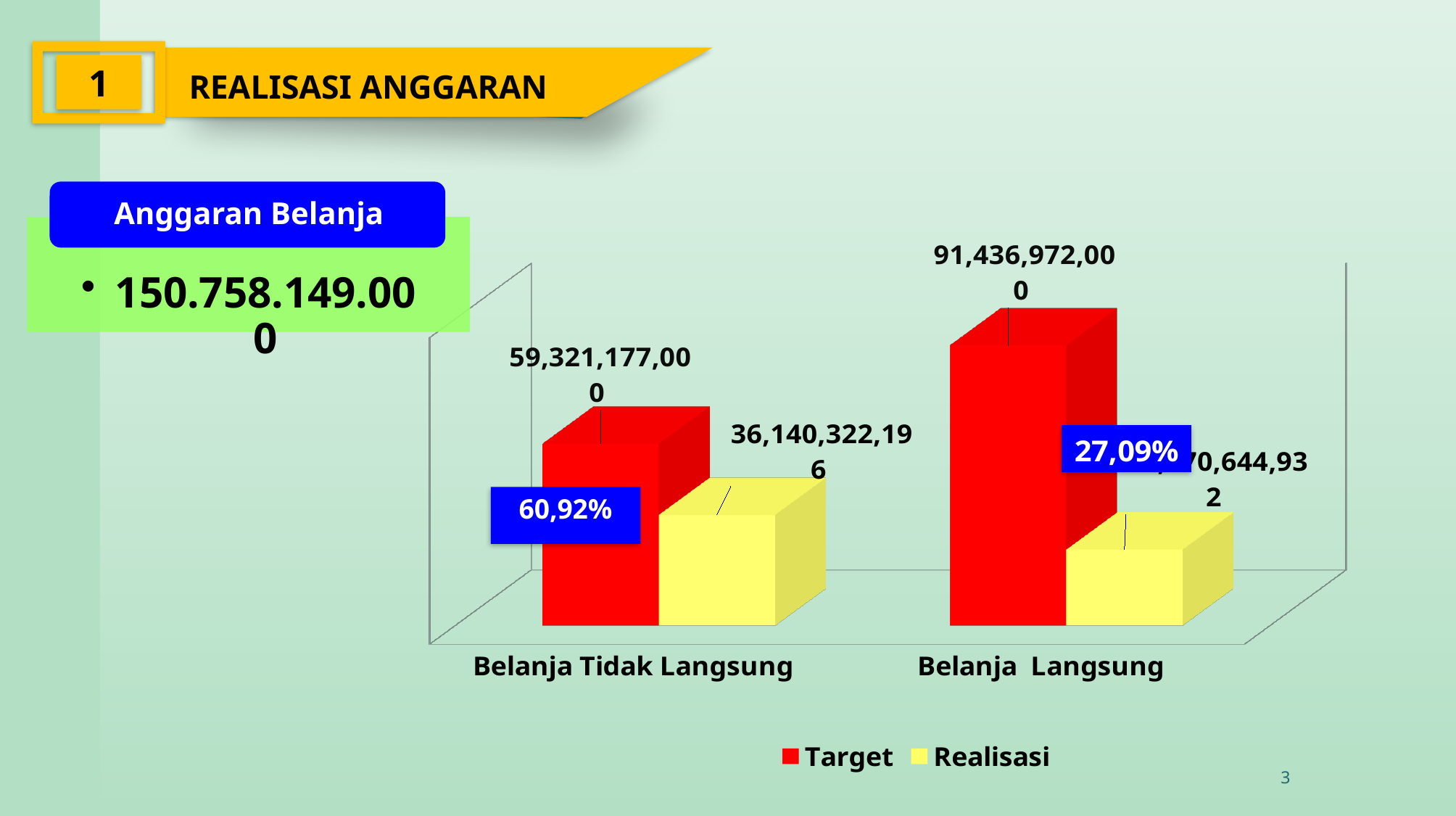
What type of chart is shown on the slide? bar chart What is the difference between the Target values for Belanja Langsung and Belanja Tidak Langsung? 32,115,795,000 Is the Target or the Realisasi value larger for Belanja Langsung? Target Which series is shown in red in the chart? Target What is the Realisasi value for Belanja Tidak Langsung? 36,140,322,196 How many series does the chart legend list? 2 Which category has the higher Target value? Belanja Langsung Which category has the lower Realisasi value? Belanja Langsung What is the Target value for Belanja Tidak Langsung? 59,321,177,000 What is the difference between the Target and Realisasi values for Belanja Tidak Langsung? 23,180,854,804 What is the Target value for Belanja Langsung? 91,436,972,000 How many categories are shown on the x axis of the chart? 2